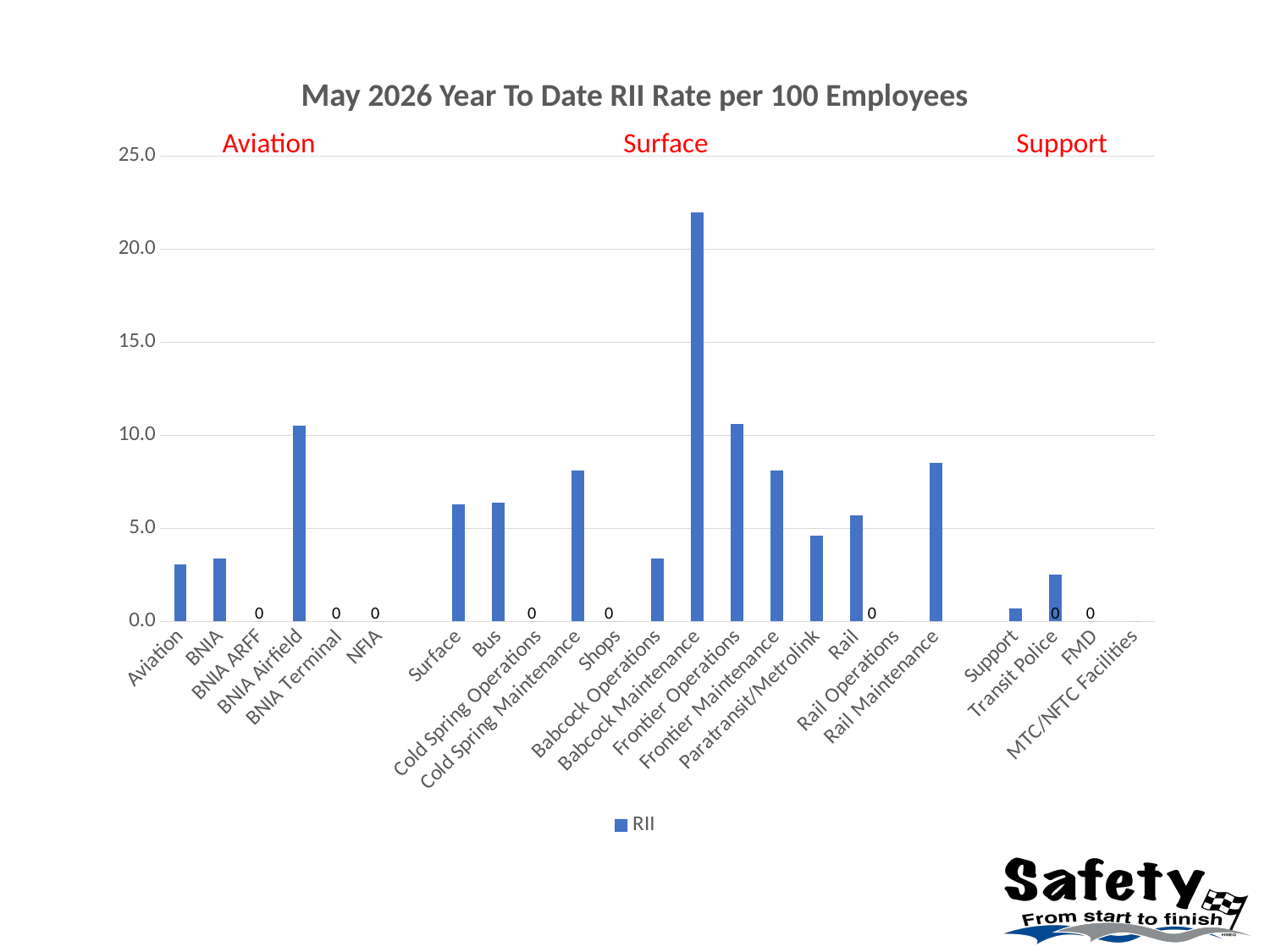
How many categories are shown on the x axis? 23 Is the value for Surface greater or less than 5.0? greater Which has a larger RII rate, Babcock Maintenance or Frontier Operations? Babcock Maintenance Is the value for Babcock Maintenance greater or less than 20.0? greater Which category has the highest RII rate? Babcock Maintenance How many series does the legend list? 1 How many categories have a printed value of 0? 8 Is the value for Rail Maintenance greater or less than 10.0? less What is the RII rate for BNIA ARFF? 0 What type of chart is shown on the slide? bar chart What is the title of the chart? May 2026 Year To Date RII Rate per 100 Employees